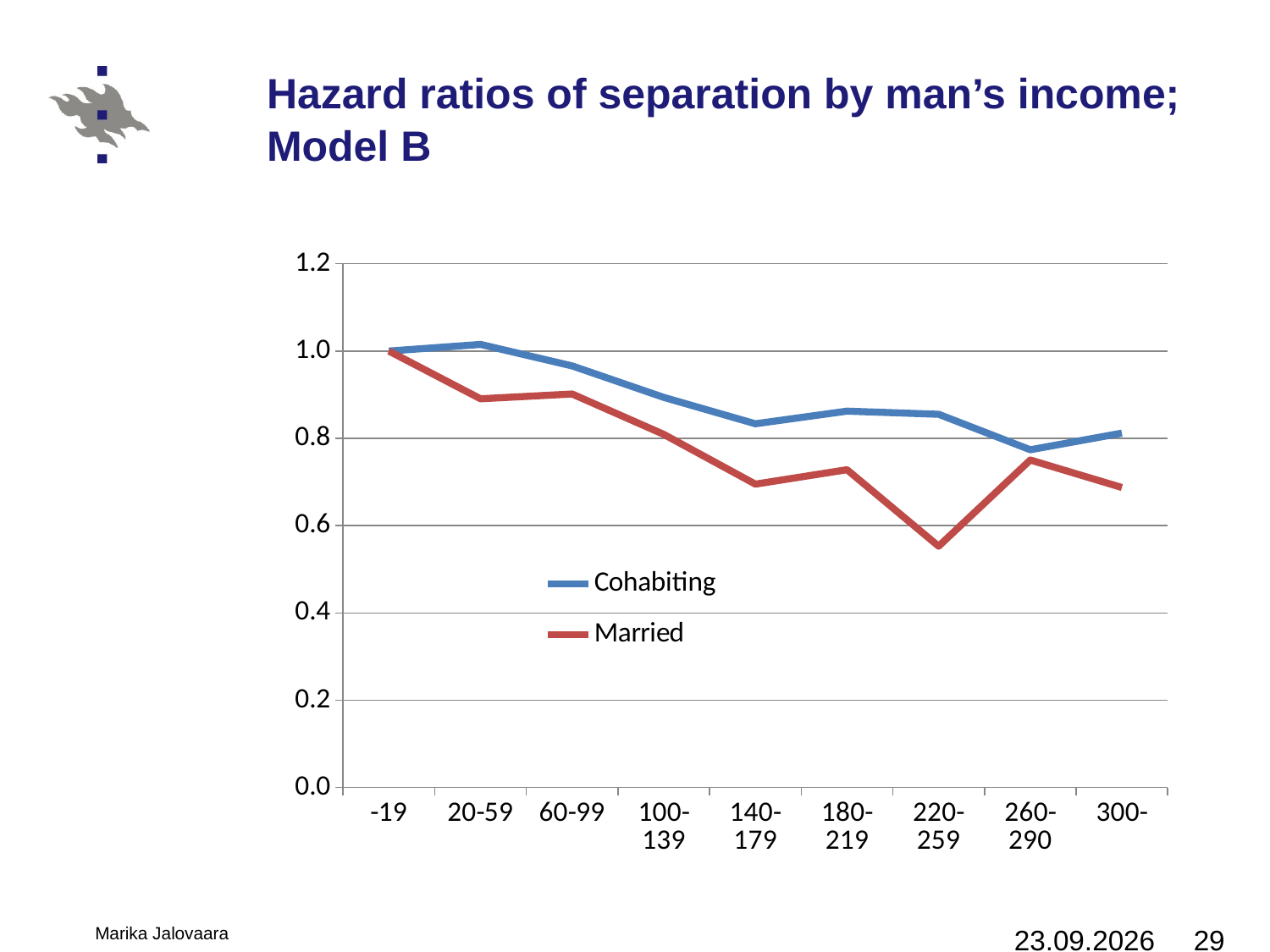
Is the Married value for 20-59 greater or less than 1.0? less For which income category is the Married hazard ratio lowest? 220-259 Which series does the red line represent? Married How many income categories are shown on the x axis? 9 At income category 220-259, which series has the larger hazard ratio, Cohabiting or Married? Cohabiting What kind of chart is shown on the slide? line chart Overall, do the hazard ratios rise or fall as man's income increases along the x axis? fall Is the Married value for 140-179 greater or less than 0.8? less Is the Cohabiting value for 140-179 greater or less than 0.8? greater How many series does the legend list? 2 For which income category is the Cohabiting hazard ratio lowest? 260-290